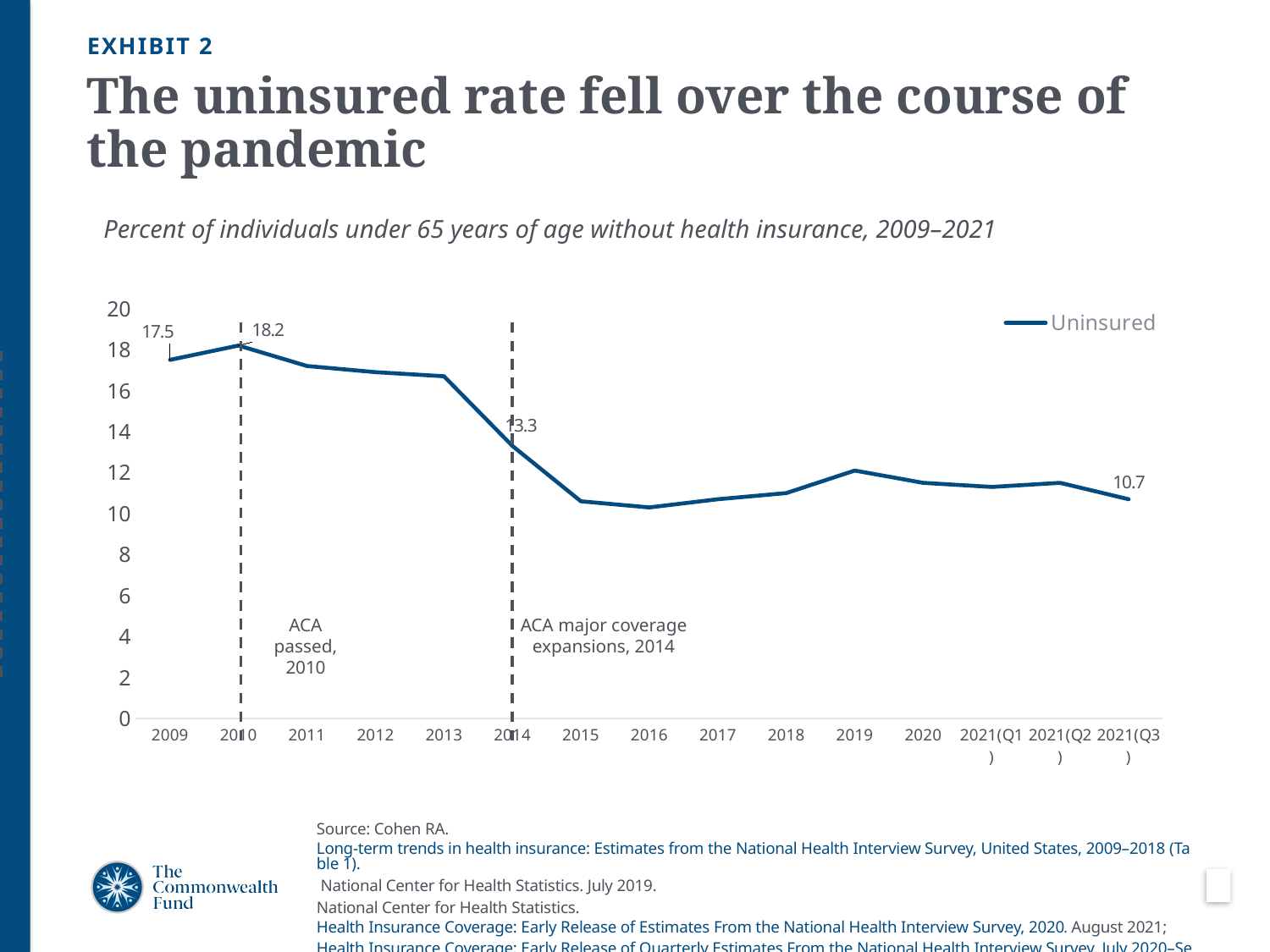
How many series does the legend list? 1 Is the uninsured rate for 2015 greater or less than 12? less What is the difference between the uninsured rate in 2009 and in 2021(Q3)? 6.8 What is the uninsured rate shown for 2010? 18.2 What is the uninsured rate shown for 2014? 13.3 What is the difference between the uninsured rate in 2010 and in 2014? 4.9 Is the uninsured rate for 2011 greater or less than 16? greater What kind of chart is shown on the slide? line chart Which year has the highest uninsured rate on the chart? 2010 What is the uninsured rate shown for 2021(Q3)? 10.7 Which is larger, the uninsured rate in 2014 or in 2021(Q3)? 2014 What is the uninsured rate shown for 2009? 17.5